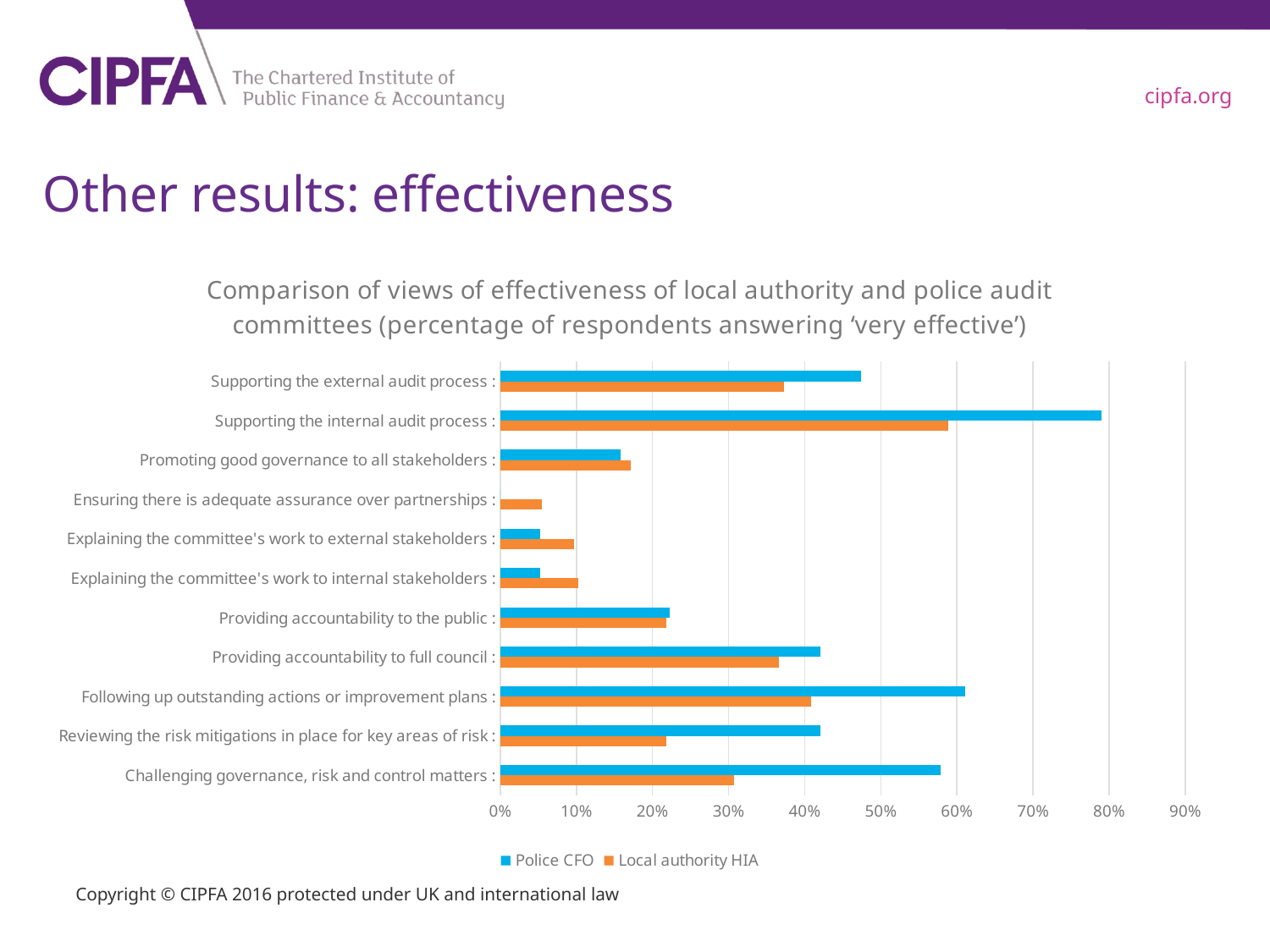
For Explaining the committee's work to external stakeholders, which series has the larger value, Police CFO or Local authority HIA? Local authority HIA What type of chart is shown on the slide? Bar chart Which colour represents the Local authority HIA series? Orange How many categories are plotted on the chart? 11 Is the Police CFO value for Supporting the internal audit process greater or less than 70%? greater Is the Local authority HIA value for Challenging governance, risk and control matters greater or less than 40%? less Which category has the lowest Local authority HIA value? Ensuring there is adequate assurance over partnerships Is the Police CFO value for Following up outstanding actions or improvement plans greater or less than 50%? greater Which category has the highest Police CFO value? Supporting the internal audit process How many series does the legend list? 2 For Reviewing the risk mitigations in place for key areas of risk, which series has the larger value, Police CFO or Local authority HIA? Police CFO Which category has the highest Local authority HIA value? Supporting the internal audit process